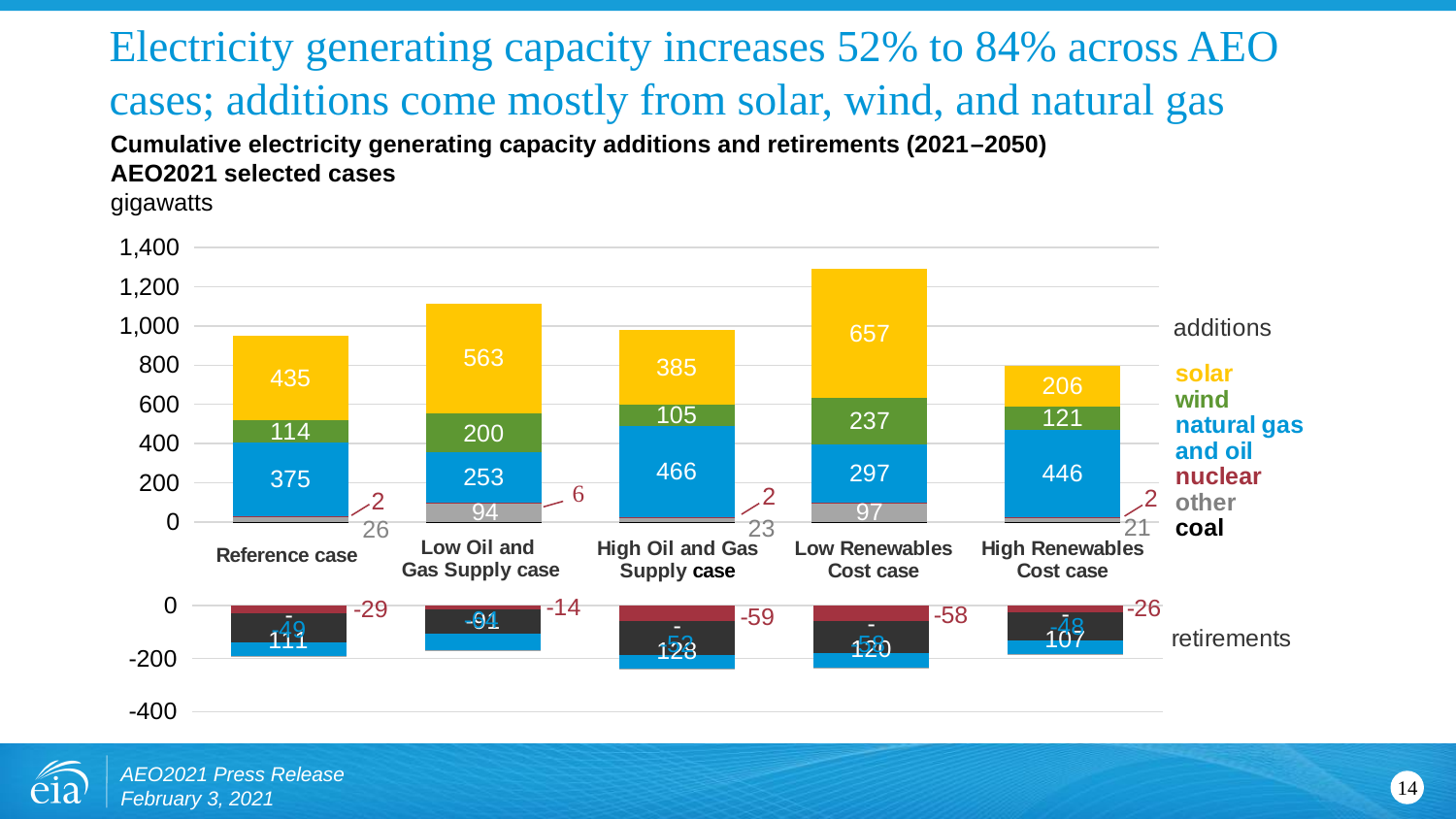
In the additions chart, what is the difference between the natural gas and oil additions in the High Oil and Gas Supply case and the Low Oil and Gas Supply case? 213 In the additions chart, what is the wind capacity addition for the Reference case? 114 In the additions chart, what is the 'other' capacity addition for the Low Renewables Cost case? 97 In the additions chart, what is the solar capacity addition for the Low Renewables Cost case? 657 In the additions chart, which case has larger wind additions: the Low Oil and Gas Supply case or the Low Renewables Cost case? Low Renewables Cost case In the additions chart, what is the difference between the solar additions in the Low Renewables Cost case and the High Renewables Cost case? 451 In the additions chart, what is the nuclear capacity addition for the Low Oil and Gas Supply case? 6 In the additions chart, which case has the lowest solar capacity addition? High Renewables Cost case How many AEO cases are shown on the x axis of the additions chart? 5 How many fuel types does the legend of the chart list? 6 In the additions chart, what is the natural gas and oil capacity addition for the High Oil and Gas Supply case? 466 In the additions chart, which case has the highest solar capacity addition? Low Renewables Cost case